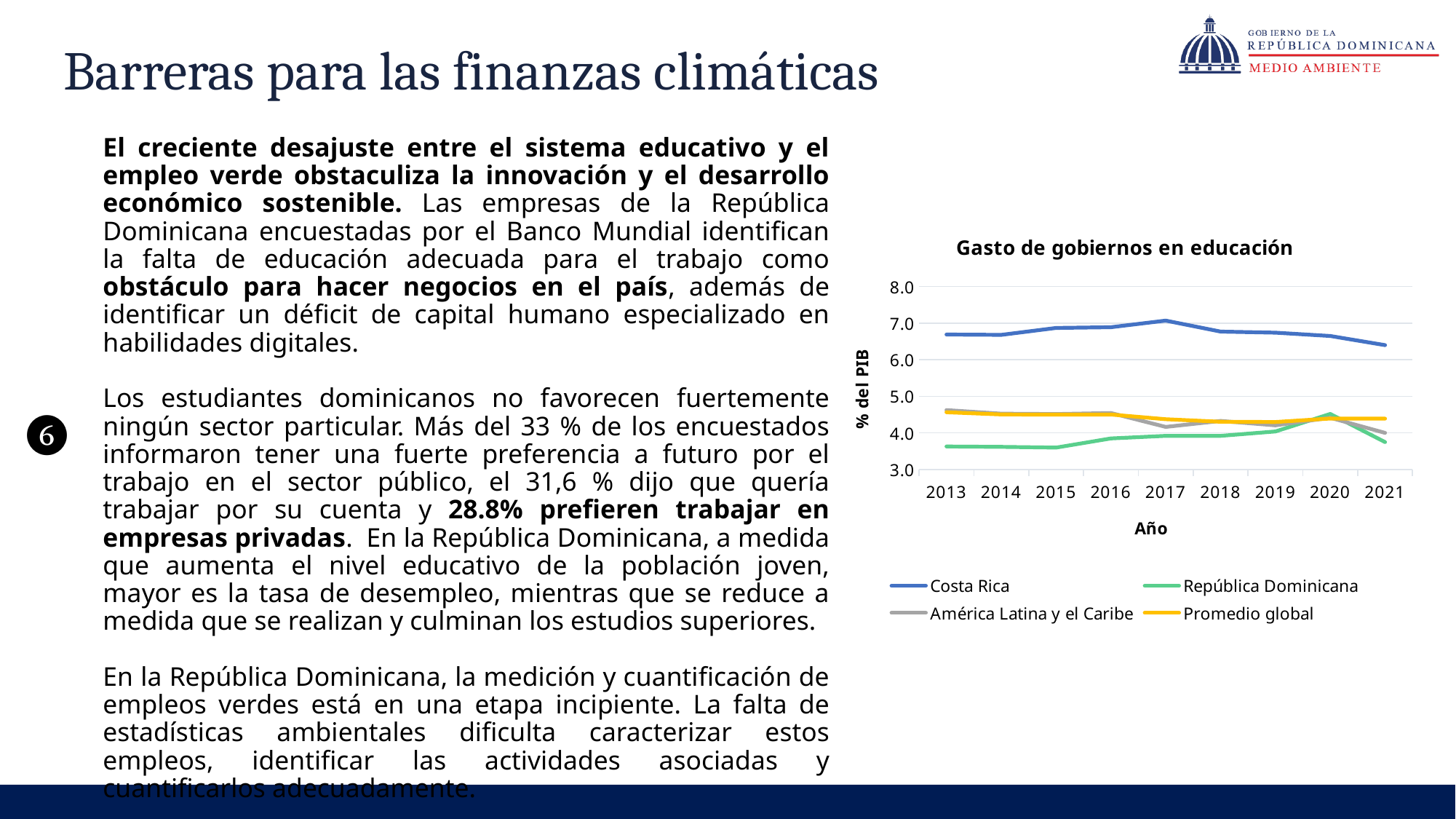
Which is larger in 2013, the value for Costa Rica or the value for República Dominicana? Costa Rica What is the title of the chart? Gasto de gobiernos en educación Does the Costa Rica line rise or fall from 2017 to 2021? fall Is the value for República Dominicana in 2013 greater or less than 4.0? less How many series does the chart's legend list? 4 What kind of chart is shown on the slide? line chart What is the label of the y axis of the chart? % del PIB Which series has the highest values across all years in the chart? Costa Rica Which series has the lowest value in 2013? República Dominicana Is the value for Costa Rica in 2021 greater or less than 7.0? less How many years are plotted along the x axis of the chart? 9 In which year does the Costa Rica line reach its highest value? 2017